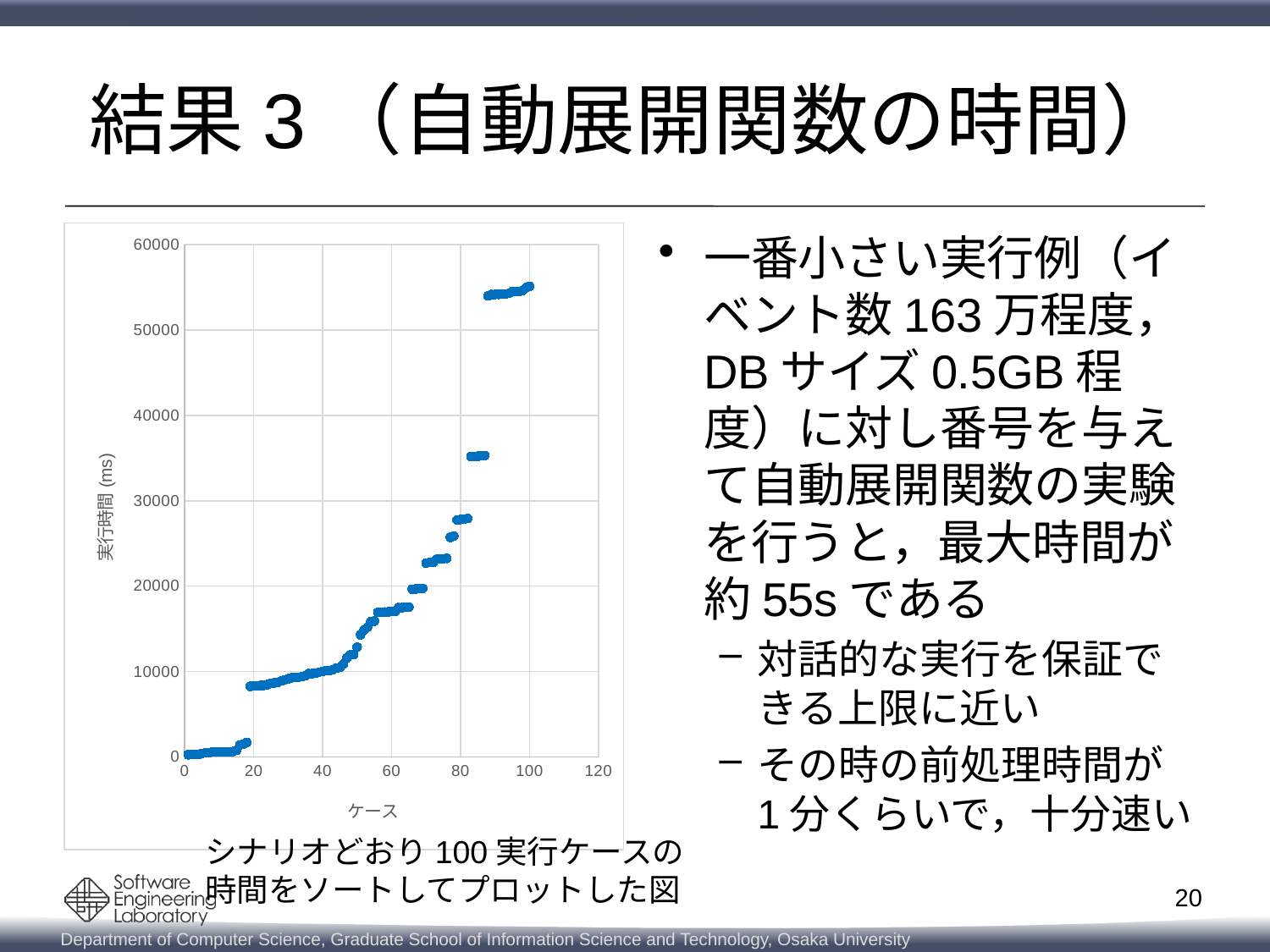
What is the label of the y axis of the chart? 実行時間 (ms) Is the execution time for case 100 greater or less than 50000 ms? greater Is the execution time for case 80 greater or less than 30000 ms? less Is the execution time for case 20 greater or less than 10000 ms? less What kind of chart is shown on the slide? scatter chart Do the plotted execution times rise or fall as the case number increases along the x axis? rise Which has the larger execution time, case 40 or case 90? case 90 What is the highest tick value shown on the y axis of the chart? 60000 According to the caption, how many execution cases are plotted in the chart? 100